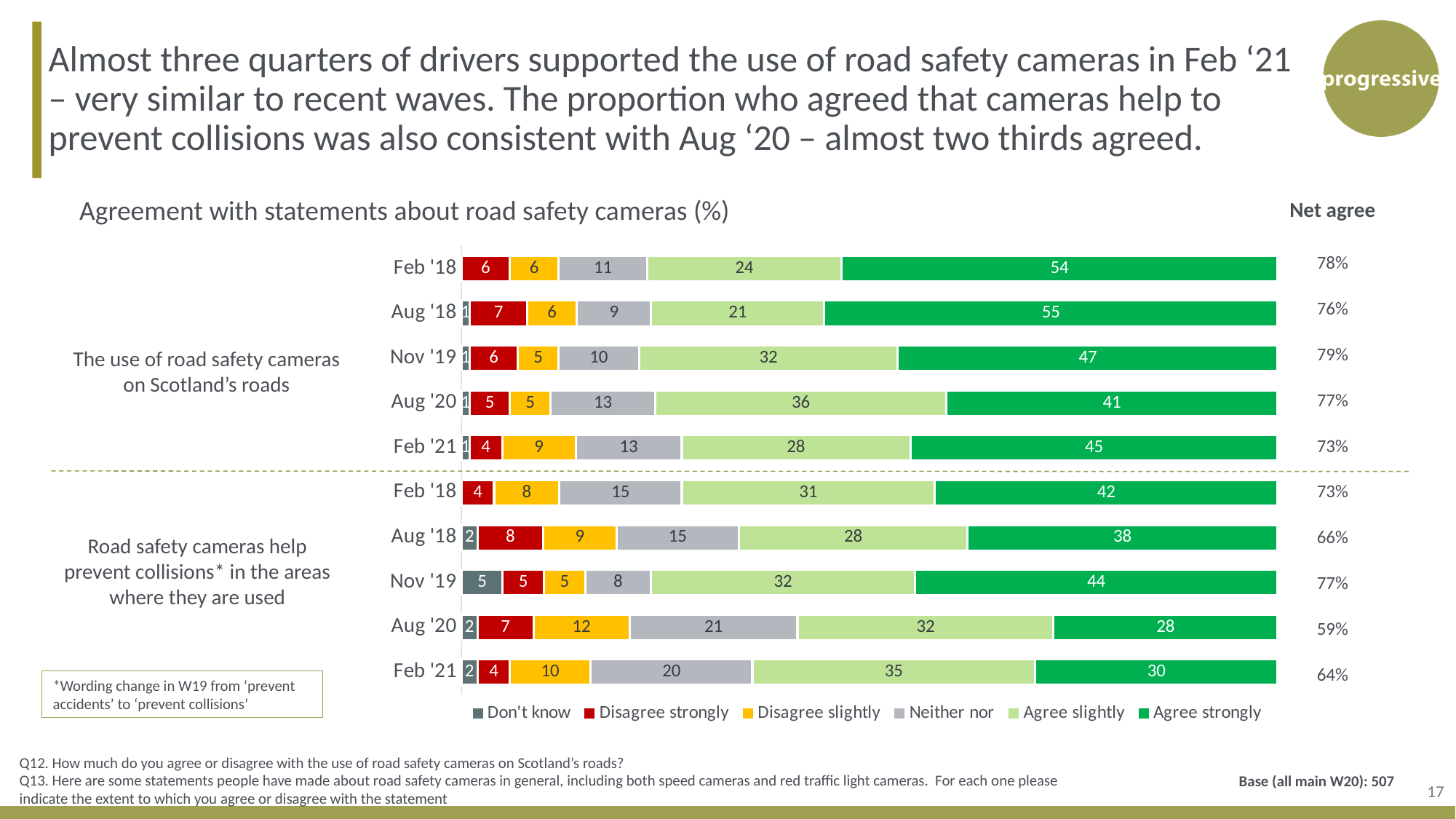
Which wave has the lowest Net agree figure for 'Road safety cameras help prevent collisions in the areas where they are used'? Aug '20 Which wave has the highest Net agree figure for 'The use of road safety cameras on Scotland's roads'? Nov '19 Which legend entry is shown in red? Disagree strongly How many series does the legend list? 6 For 'The use of road safety cameras on Scotland's roads', what is the difference between the 'Agree strongly' values for Feb '18 and Feb '21? 9 What kind of chart is shown on the slide? Stacked bar chart What is the Net agree figure for Feb '21 for 'The use of road safety cameras on Scotland's roads'? 73% How many bars are plotted in the chart in total? 10 For 'Road safety cameras help prevent collisions in the areas where they are used', what is the 'Neither nor' value for Aug '20? 21 For 'The use of road safety cameras on Scotland's roads', what is the 'Agree strongly' value for Feb '18? 54 For 'Road safety cameras help prevent collisions', is the 'Agree slightly' value for Feb '21 larger or smaller than the 'Agree strongly' value for Feb '21? Larger What is the total of the stacked bar for Feb '21 under 'The use of road safety cameras on Scotland's roads'? 100